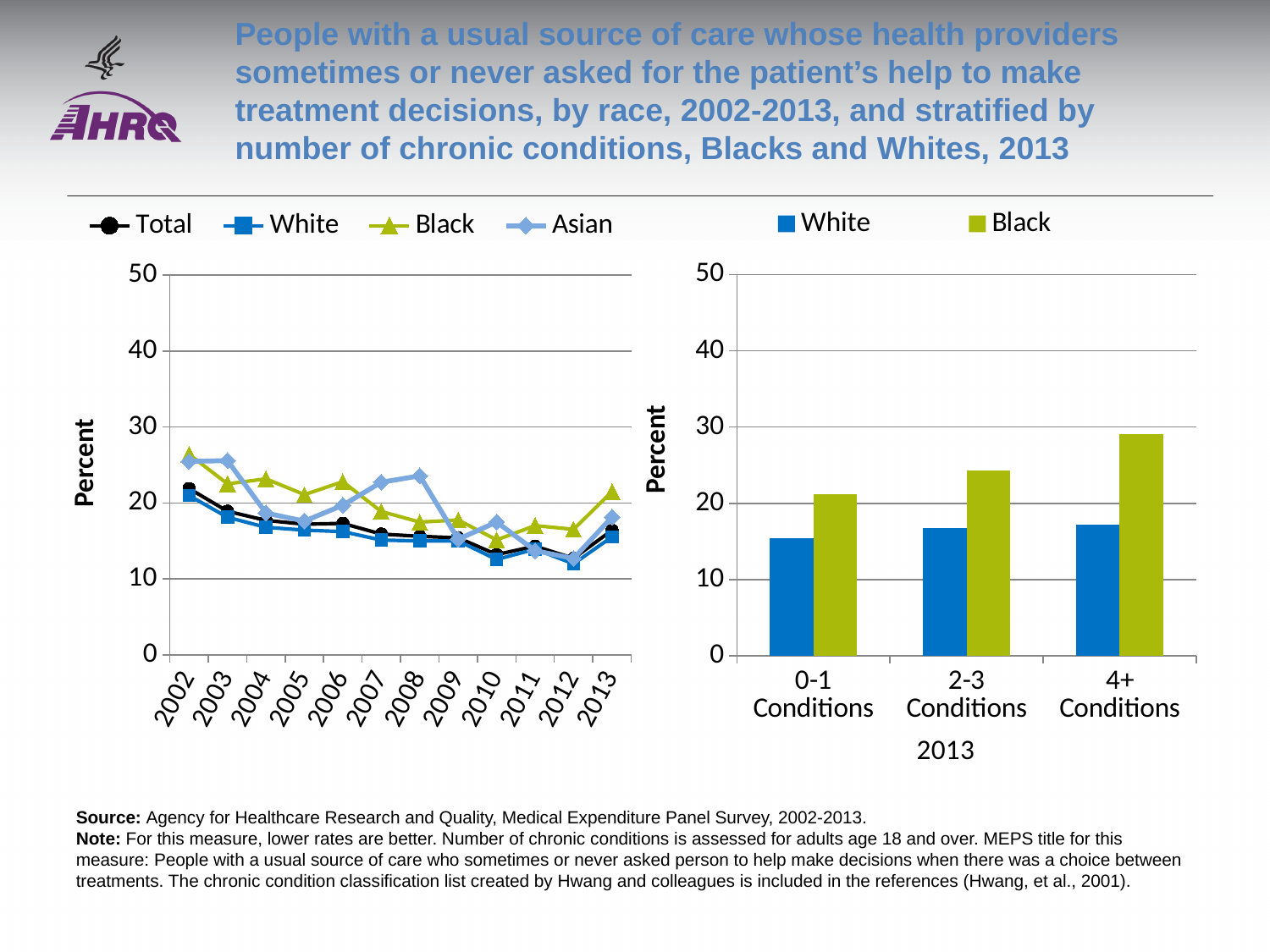
In the left chart, does the White series rise or fall from 2002 to 2013? fall In the left chart, how many years are plotted along the x axis? 12 What kind of chart is the left chart? Line chart In the right chart, is the value for Black with 4+ Conditions greater or less than 20? greater In the left chart, is the value for White in 2013 greater or less than 20? less In the right chart, how many series does the legend list? 2 In the left chart, is the value for Black in 2002 greater or less than 20? greater In the left chart, which series has the highest value in 2013? Black In the right chart, which bar is the highest? Black, 4+ Conditions In the left chart, how many series does the legend list? 4 In the right chart, how many categories are shown on the x axis? 3 What kind of chart is the right chart? Bar chart